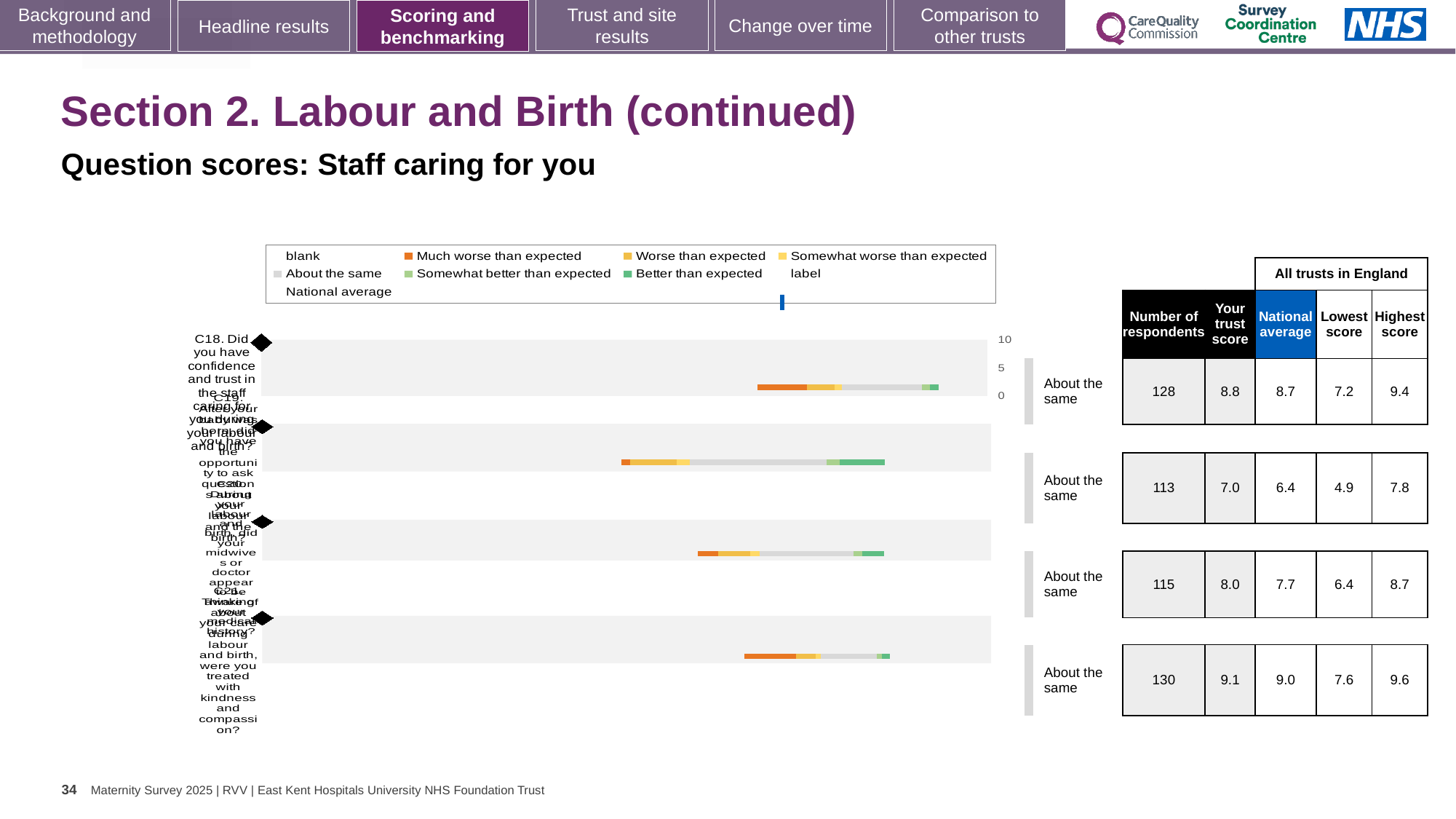
How many questions (bars) are plotted in the chart? 4 In the table, what is the highest score among all trusts in England for the bottom row? 9.6 What comparison label is shown next to each bar in the chart? About the same Which row of the table has the highest 'Your trust score'? the fourth (bottom) row, 9.1 What kind of chart is shown on the slide? bar chart Which row of the table has the lowest national average? the second row, 6.4 How many more respondents does the top row have than the second row? 15 In the table beside the chart, what is the trust score for the top question (C18)? 8.8 In the table beside the chart, what is the number of respondents for the top question (C18)? 128 In the table beside the chart, what is the national average for the top question (C18)? 8.7 For the top question (C18), what is the difference between the trust score and the national average? 0.1 For the second row of the table, which is larger: the trust score or the national average? the trust score (7.0)